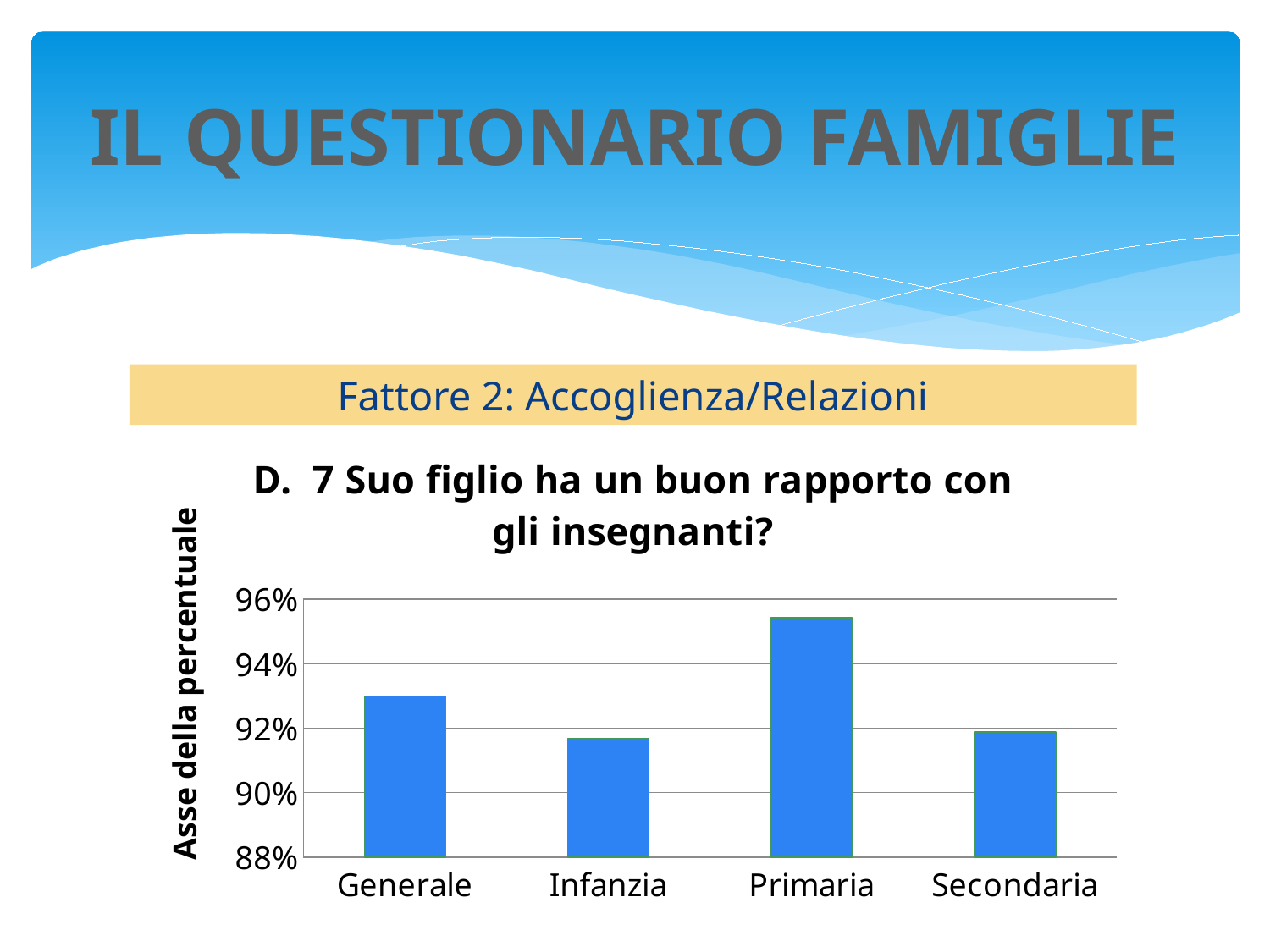
Is the value for Generale greater or less than 92%? greater Is the value for Primaria greater or less than 96%? less What is the title of the chart? D. 7 Suo figlio ha un buon rapporto con gli insegnanti? Is the value for Secondaria greater or less than 94%? less Which is larger, the value for Primaria or the value for Generale? Primaria Which is larger, the value for Generale or the value for Infanzia? Generale How many categories are shown on the x axis of the chart? 4 What type of chart is shown on the slide? bar chart What is the label of the vertical axis of the chart? Asse della percentuale Which category has the highest value in the chart? Primaria